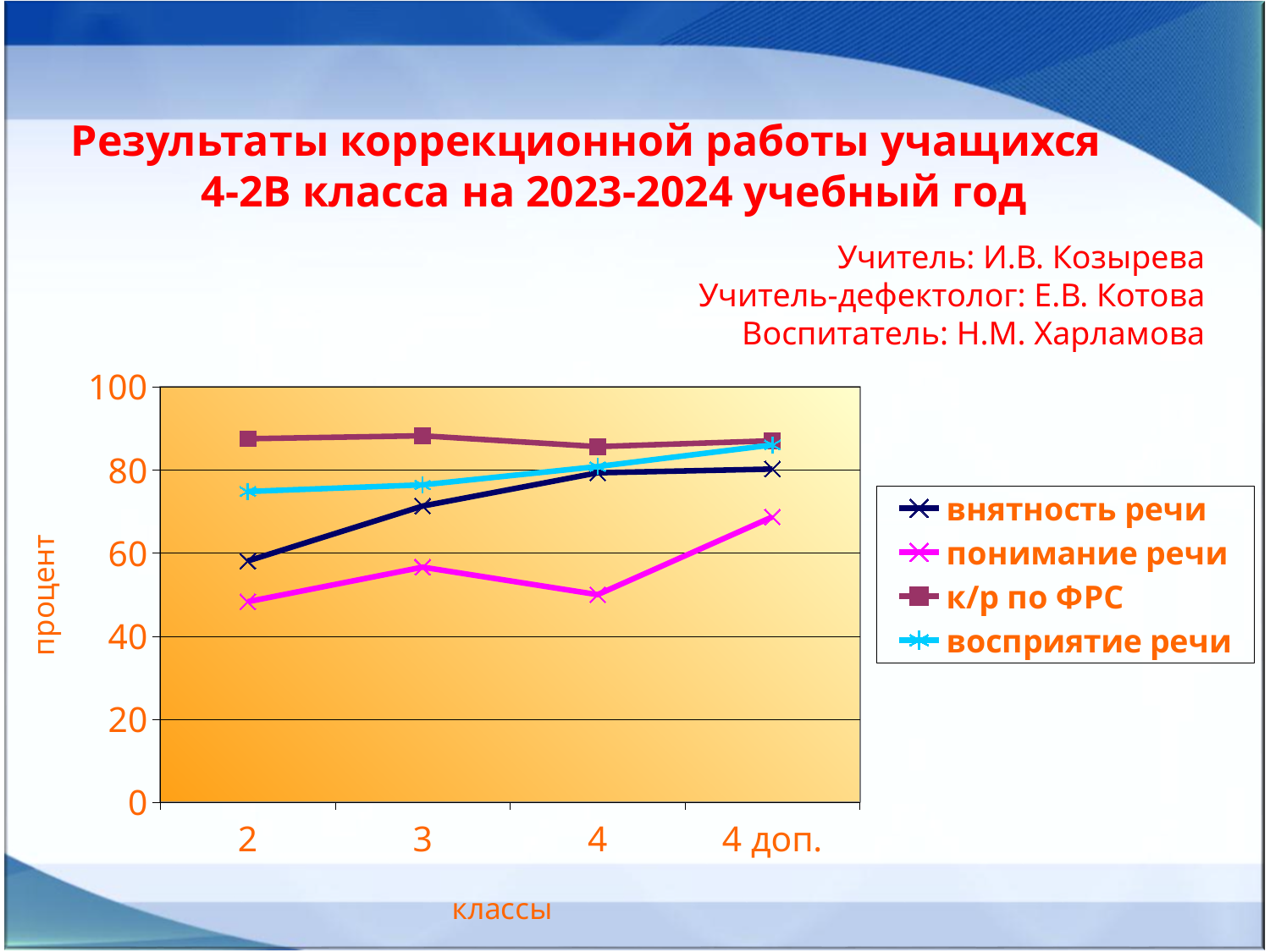
Is the value for понимание речи at class 2 greater or less than 60? less Is the value for восприятие речи at class 4 доп. greater or less than 80? greater What is the label of the vertical axis? процент Is the value for к/р по ФРС at class 3 greater or less than 80? greater Does the внятность речи series rise or fall from class 2 to class 4 доп.? rises How many categories are shown on the x axis? 4 Which series has the lowest value at class 4? понимание речи What kind of chart is shown on the slide? line chart How many series does the legend list? 4 Which series has the highest value at class 2? к/р по ФРС At class 3, which is larger: внятность речи or понимание речи? внятность речи